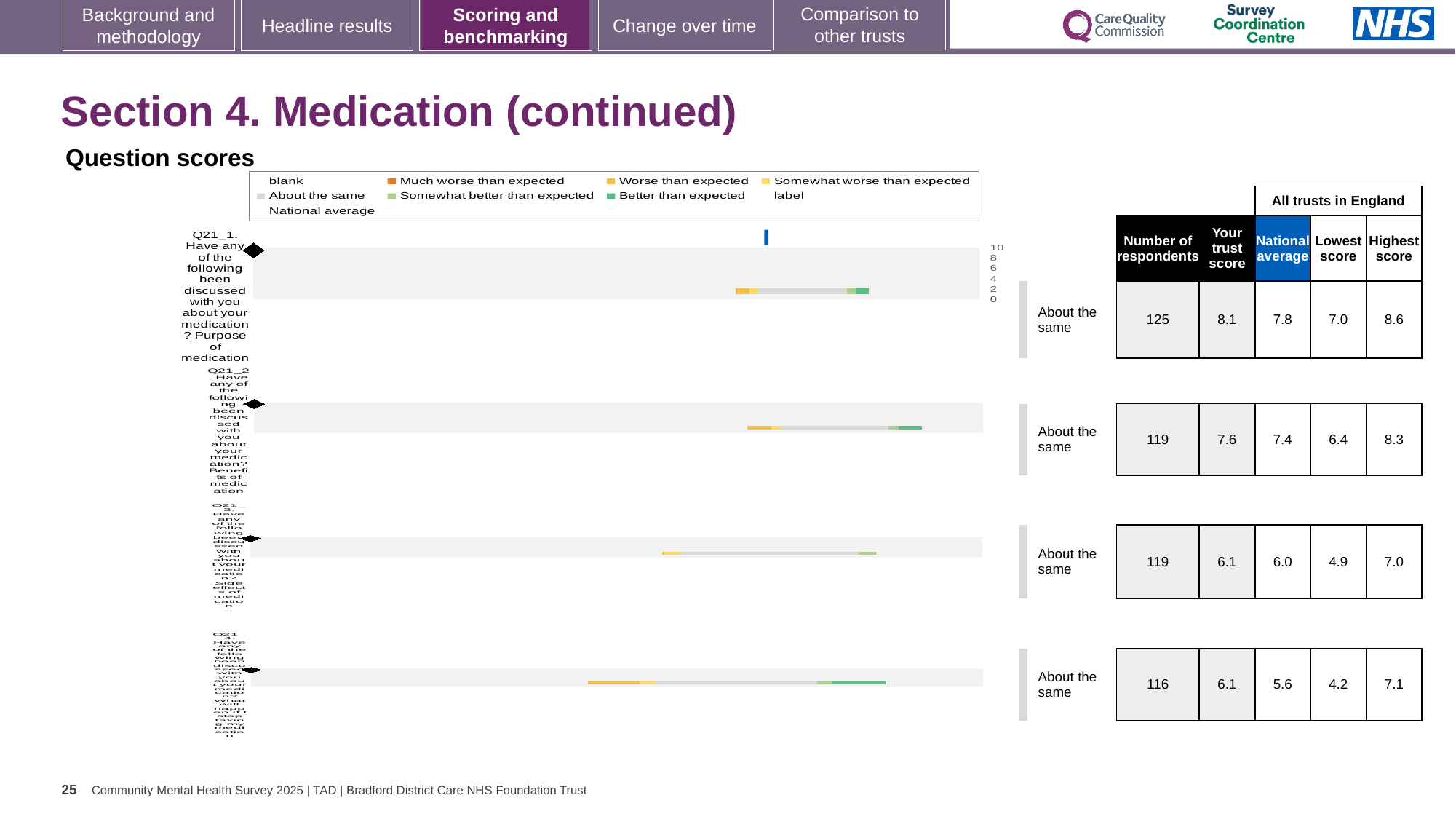
What kind of chart is shown under 'Question scores'? bar chart What is the highest tick value shown on the chart's axis? 10 In the table beside the chart, what is the number of respondents for Q21_1 (Purpose of medication)? 125 In the table beside the chart, what is 'Your trust score' for Q21_2 (Benefits of medication)? 7.6 What benchmark category label is shown next to each of the four bars? About the same How many entries does the chart's legend list? 9 In the table beside the chart, what is the national average for Q21_4? 5.6 Which legend entry in the chart is shown in grey? About the same In the table beside the chart, what is the difference between the highest score and lowest score for Q21_3? 2.1 In the table beside the chart, which question has the lowest 'Lowest score' across all trusts in England? Q21_4 How many question categories (bars) are plotted in the chart? 4 In the table beside the chart, is 'Your trust score' for Q21_1 larger or smaller than the national average? larger